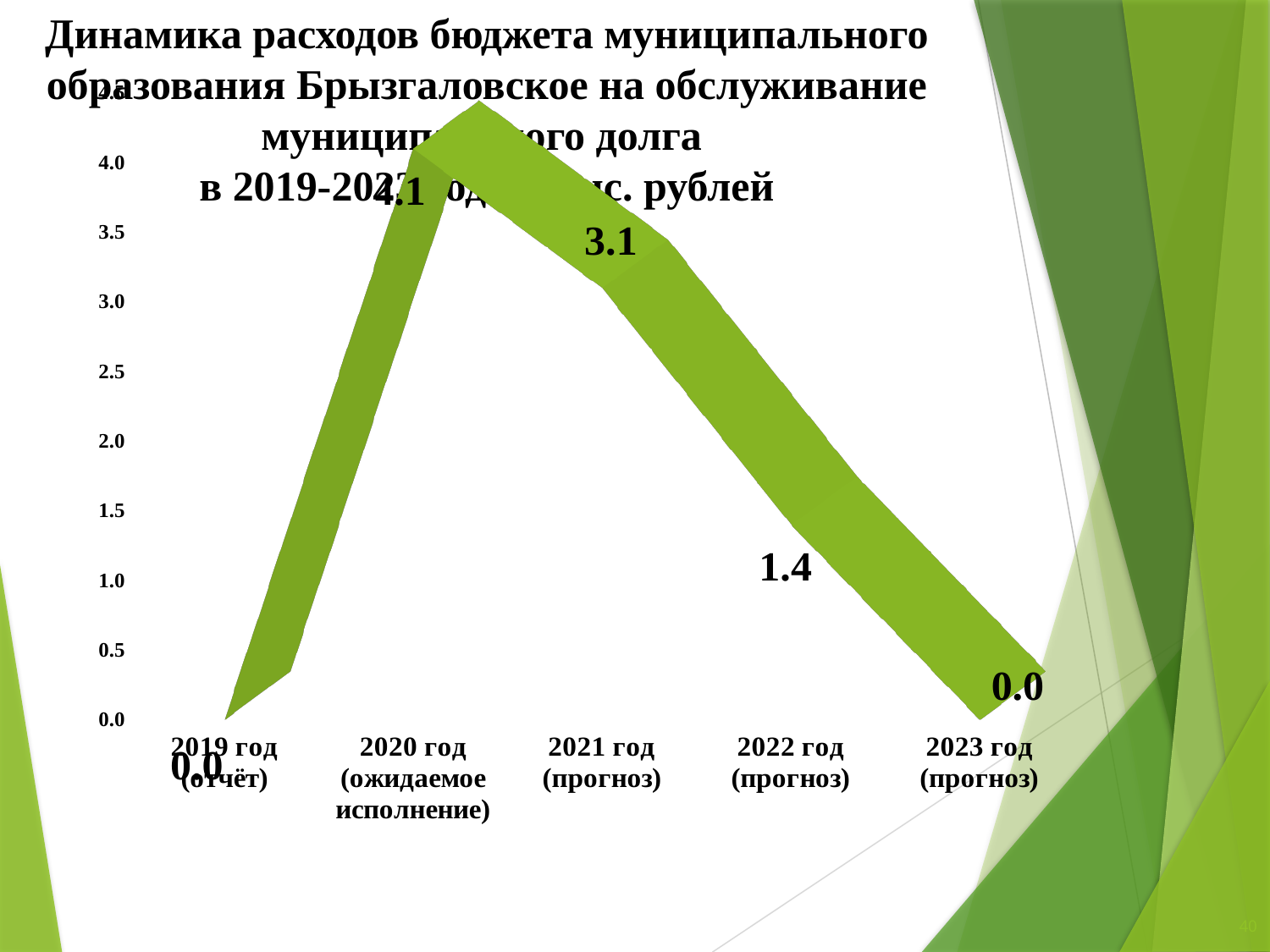
What is the value for 2022 год (прогноз)? 1.4 What is the value for 2019 год (отчёт)? 0.0 What is the value for 2020 год (ожидаемое исполнение)? 4.1 How many years are plotted on the chart? 5 Is the value for 2020 год (ожидаемое исполнение) greater or less than 4.0? greater Which year has the highest value? 2020 год (ожидаемое исполнение) Which is larger, the value for 2021 год (прогноз) or for 2022 год (прогноз)? 2021 год (прогноз) What is the value for 2023 год (прогноз)? 0.0 What is the value for 2021 год (прогноз)? 3.1 Do the values rise or fall from 2020 год to 2023 год? fall What is the difference between the values for 2021 год (прогноз) and 2022 год (прогноз)? 1.7 What kind of chart is shown on the slide? line chart